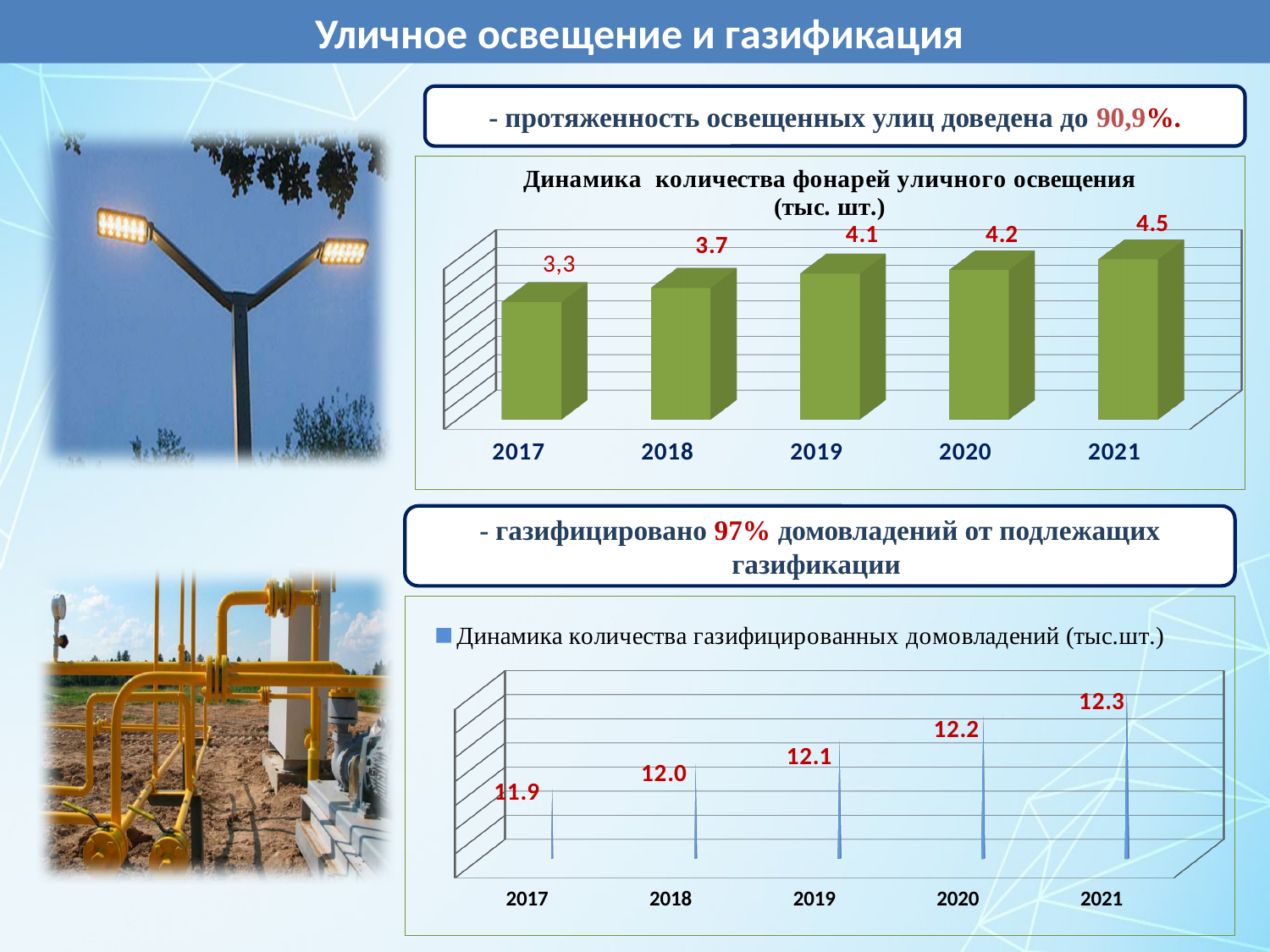
In the bottom chart (Динамика количества газифицированных домовладений), what is the value for 2017? 11.9 In the top chart (Динамика количества фонарей уличного освещения), what is the value for 2021? 4.5 In the top chart (Динамика количества фонарей уличного освещения), how many years are shown on the x axis? 5 In the bottom chart (Динамика количества газифицированных домовладений), which is larger, the value for 2020 or the value for 2018? 2020 In the top chart (Динамика количества фонарей уличного освещения), do the values rise or fall from 2017 to 2021? rise In the top chart (Динамика количества фонарей уличного освещения), what is the difference between the values for 2021 and 2018? 0.8 In the top chart (Динамика количества фонарей уличного освещения), which year has the highest value? 2021 In the top chart (Динамика количества фонарей уличного освещения), which year has the lowest value? 2017 What kind of chart is the top chart (Динамика количества фонарей уличного освещения)? bar chart In the bottom chart (Динамика количества газифицированных домовладений), what is the value for 2019? 12.1 In the bottom chart (Динамика количества газифицированных домовладений), what is the difference between the values for 2021 and 2017? 0.4 In the top chart (Динамика количества фонарей уличного освещения), what is the value for 2017? 3,3